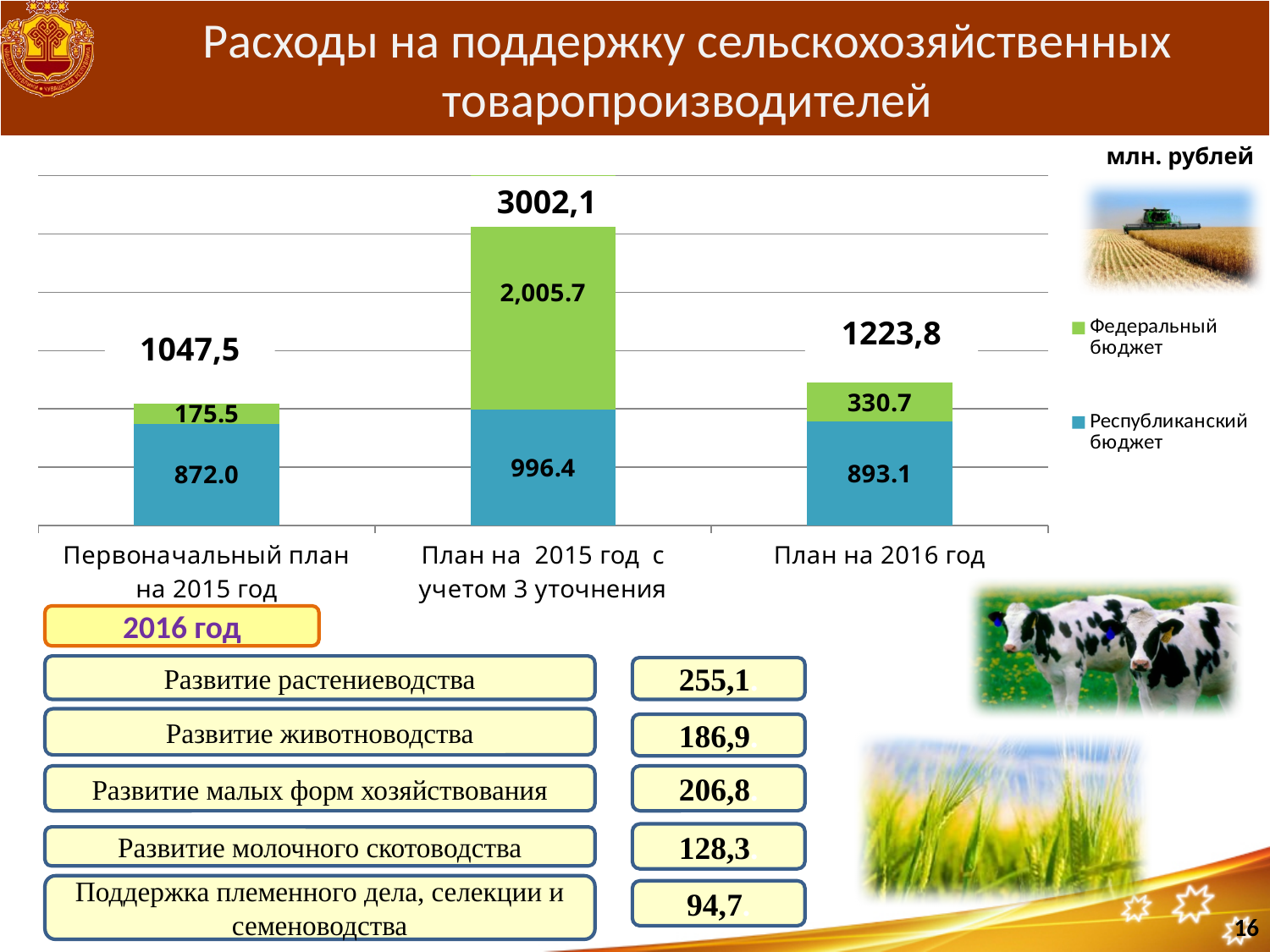
What is the total of the stacked bar for План на 2015 год с учетом 3 уточнения? 3002,1 What type of chart is shown on the slide? stacked bar chart What is the total of the stacked bar for План на 2016 год? 1223,8 How many categories are shown on the x axis of the chart? 3 What is the value of Федеральный бюджет for План на 2015 год с учетом 3 уточнения? 2,005.7 Which category has the lowest Федеральный бюджет value? Первоначальный план на 2015 год How many series does the chart legend list? 2 What is the difference between the Республиканский бюджет values for План на 2015 год с учетом 3 уточнения and План на 2016 год? 103.3 Which is larger: Федеральный бюджет for План на 2016 год or Федеральный бюджет for Первоначальный план на 2015 год? План на 2016 год What is the value of Федеральный бюджет for План на 2016 год? 330.7 What is the value of Республиканский бюджет for Первоначальный план на 2015 год? 872.0 Which category has the highest total value? План на 2015 год с учетом 3 уточнения